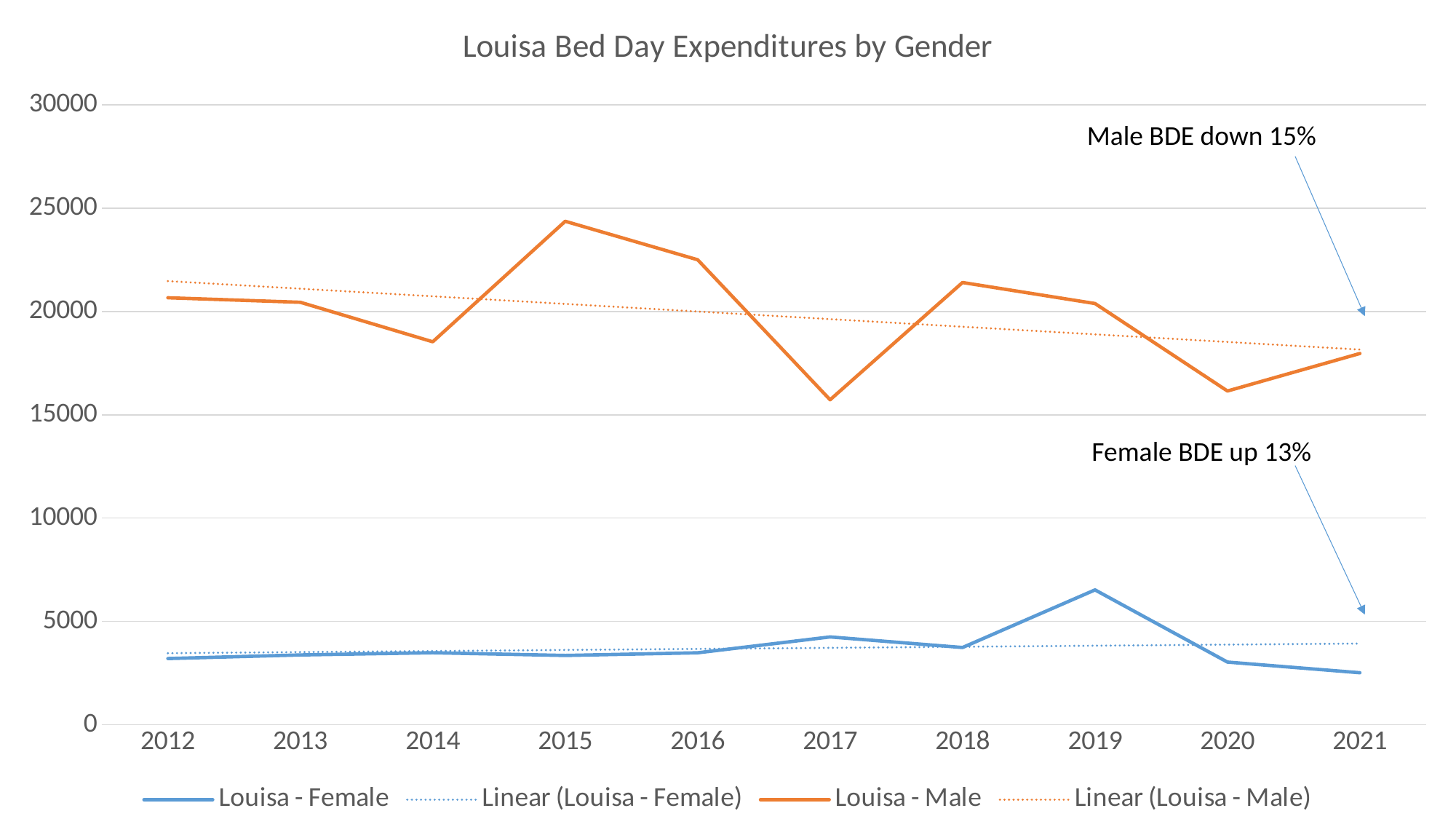
How many years are shown on the x axis? 10 How many entries does the legend list? 4 What kind of chart is shown on the slide? Line chart Is the Louisa - Male value for 2017 greater or less than 20000? less In which year is the Louisa - Male value lowest? 2017 According to the annotation on the chart, by what percentage is Male BDE down? 15% Is the Louisa - Male value for 2015 greater or less than 20000? greater In which year is the Louisa - Female value highest? 2019 Which series has the larger value in 2021, Louisa - Male or Louisa - Female? Louisa - Male Is the Louisa - Female value for 2019 greater or less than 5000? greater What is the title of the chart? Louisa Bed Day Expenditures by Gender In which year is the Louisa - Male value highest? 2015